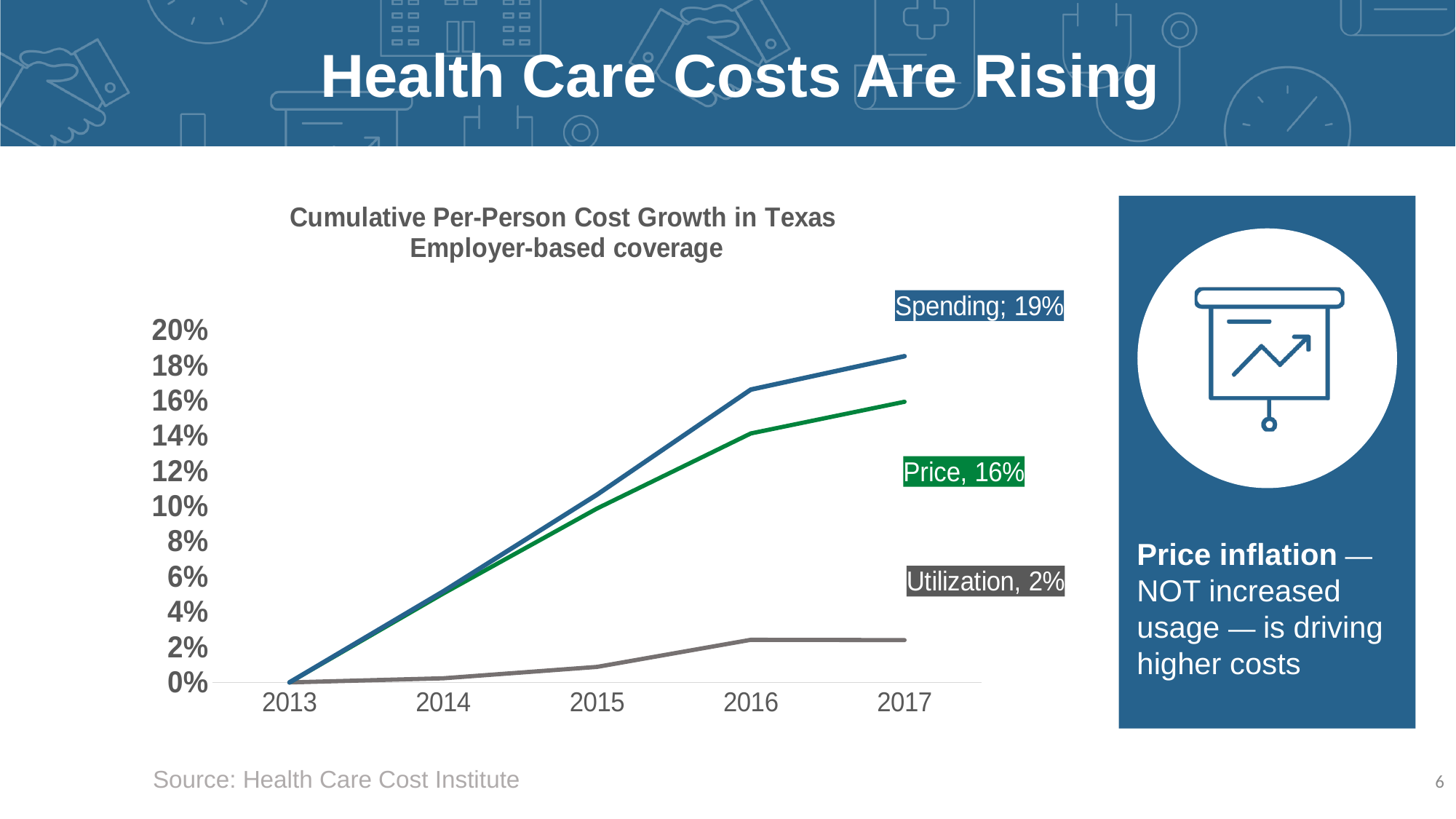
Is the value for Spending in 2015 greater or less than 8%? greater How many years are shown on the x axis? 5 What is the cumulative Price growth value shown for 2017? 16% What type of chart is shown on the slide? Line chart Which series has the highest value in 2017? Spending What is the difference between the Spending and Price values labeled for 2017? 3 percentage points What is the cumulative Spending growth value shown for 2017? 19% How many series are plotted on the chart? 3 Is the value for Utilization in 2015 greater or less than 2%? less Which series has the lowest value in 2017? Utilization Which is larger in 2017, Price or Utilization? Price What is the cumulative Utilization growth value shown for 2017? 2%